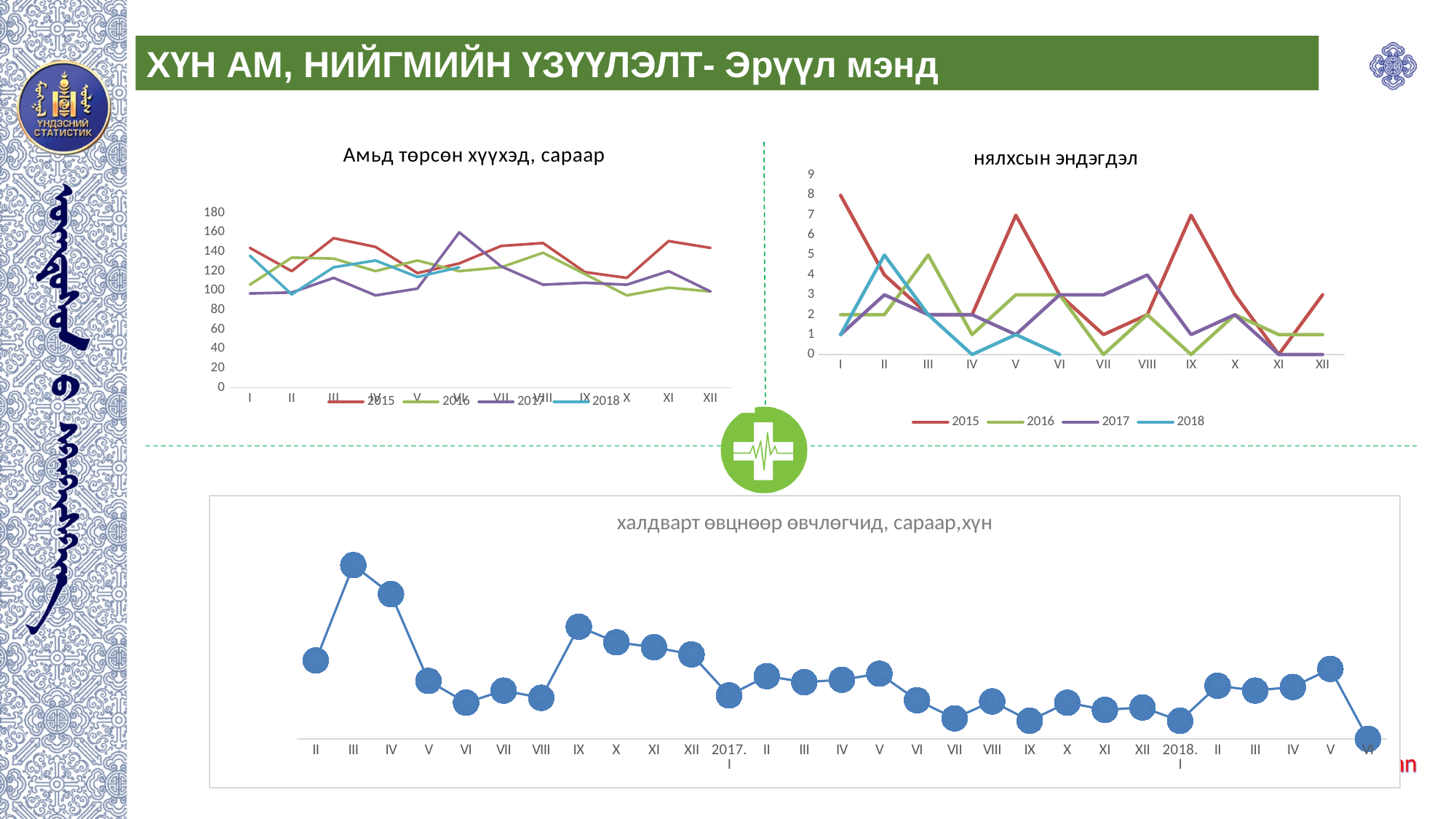
In the "Амьд төрсөн хүүхэд, сараар" chart, which series is higher in month VI, 2017 or 2016? 2017 In the "Амьд төрсөн хүүхэд, сараар" chart, is the value for 2016 in month IX greater or less than 100? greater In the "нялхсын эндэгдэл" chart, what is the difference between the 2015 value in month I and the 2018 value in month I? 7 In the "нялхсын эндэгдэл" chart, which series has the highest value in month I? 2015 In the "халдварт өвцнөөр өвчлөгчид, сараар,хүн" chart, which month has the highest point? III In the "нялхсын эндэгдэл" chart, what is the value for 2015 in month I? 8 In the "нялхсын эндэгдэл" chart, what is the value for 2018 in month IV? 0 In the "халдварт өвцнөөр өвчлөгчид, сараар,хүн" chart, how many data points are plotted? 29 In the "Амьд төрсөн хүүхэд, сараар" chart, is the value for 2015 in month III greater or less than 140? greater In the "нялхсын эндэгдэл" chart, what is the value for 2016 in month III? 5 How many series does the legend of the "нялхсын эндэгдэл" chart list? 4 What kind of chart is "Амьд төрсөн хүүхэд, сараар"? line chart